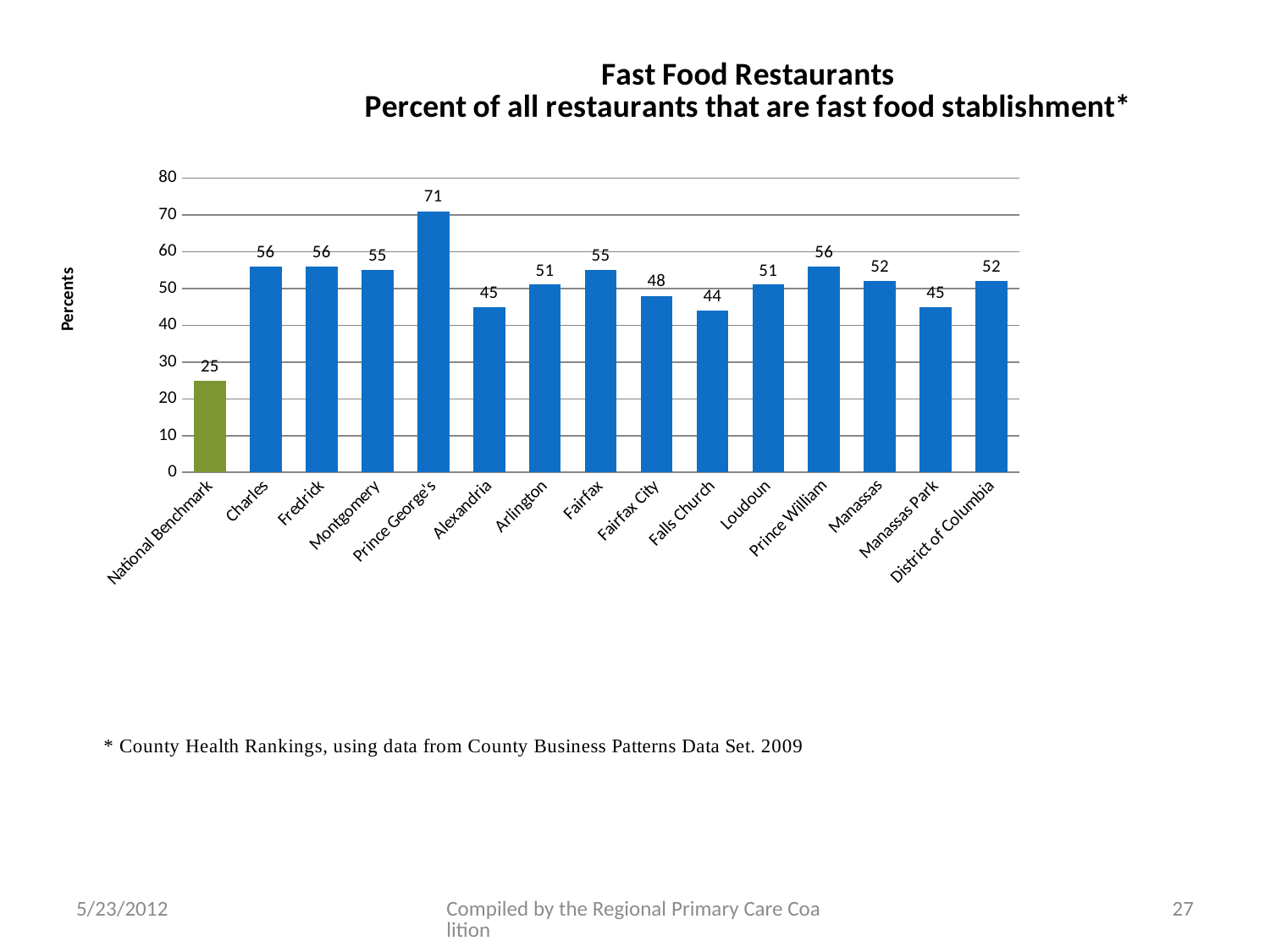
Which is larger, the value for Fairfax City or the value for Loudoun? Loudoun What is the value for Manassas Park? 45 What is the difference between the values for Prince George's and Falls Church? 27 Is the value for Arlington greater or less than 60? less What is the value for Prince George's? 71 Which category has the highest value? Prince George's What kind of chart is shown on the slide? bar chart Which category has the lowest value? National Benchmark What is the label on the vertical axis? Percents How many categories are shown on the x axis? 15 What is the value for the National Benchmark? 25 What is the value for Falls Church? 44